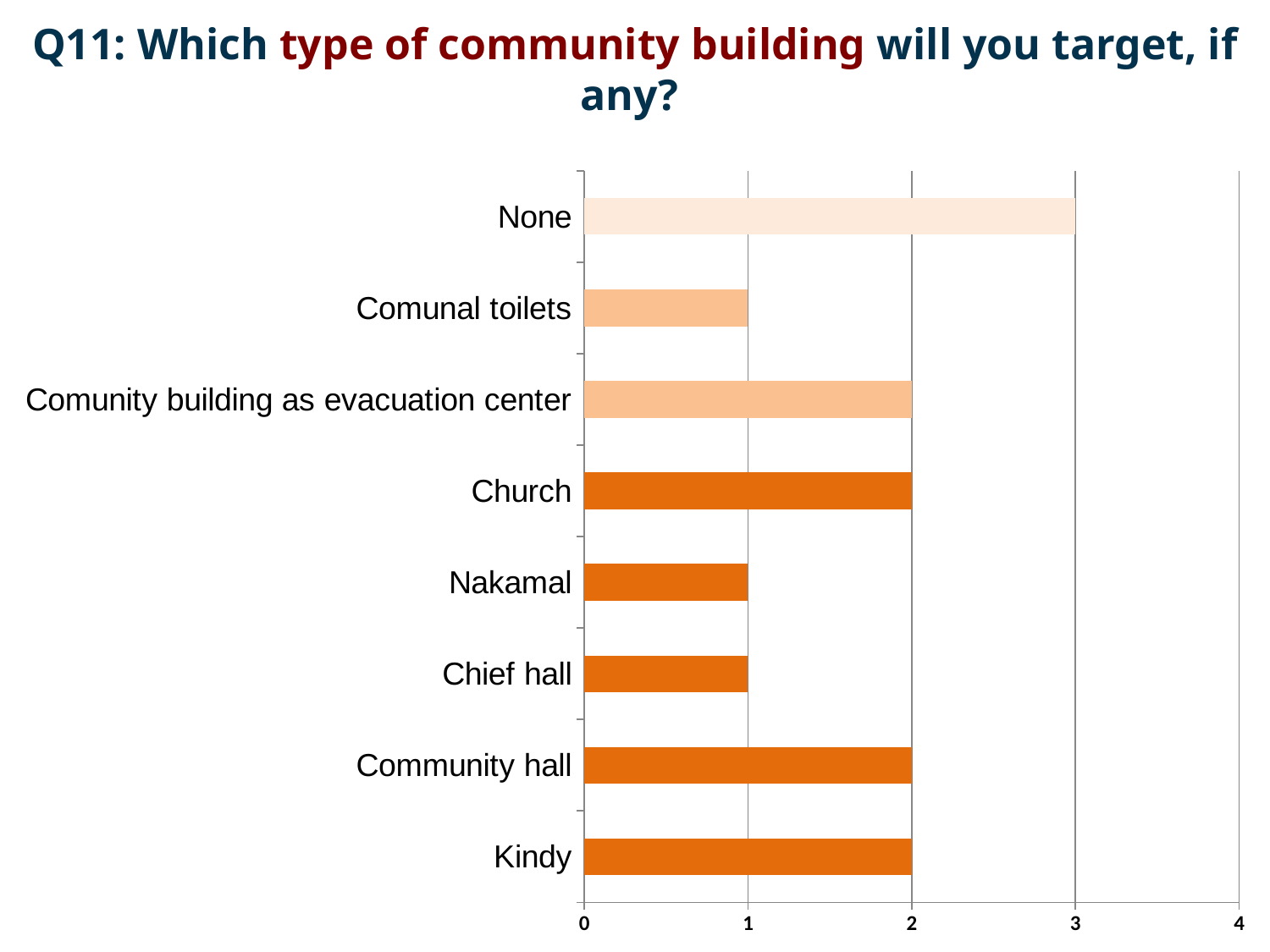
What is the value for Church? 2 What is the value for None? 3 What is the value for Nakamal? 1 How many categories are shown in the chart? 8 What type of chart is shown on the slide? Bar chart What is the difference between the values for Comunity building as evacuation center and Nakamal? 1 What is the difference between the values for None and Comunal toilets? 2 Which is larger, the value for None or the value for Chief hall? None What is the value for Community hall? 2 Which category has the highest value? None Is the value for Kindy greater or less than 1? greater What is the title of the chart? Q11: Which type of community building will you target, if any?